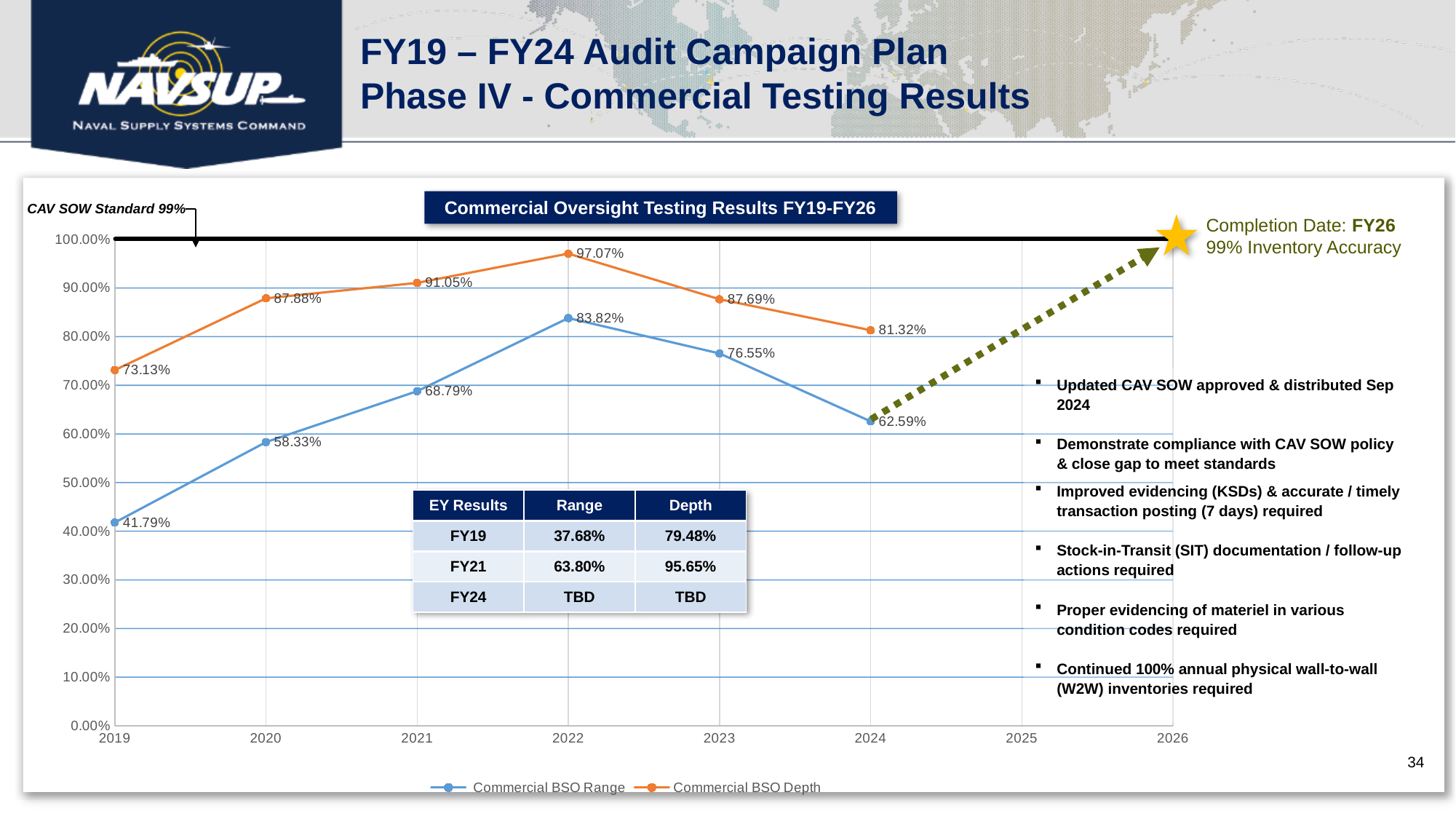
What is the Commercial BSO Range value for 2024? 62.59% In which year is Commercial BSO Range lowest? 2019 Does Commercial BSO Range rise or fall from 2022 to 2024? Fall What is the Commercial BSO Depth value for 2022? 97.07% How many years have data points plotted for Commercial BSO Range? 6 Which is larger in 2023: Commercial BSO Range or Commercial BSO Depth? Commercial BSO Depth In which year is Commercial BSO Depth highest? 2022 What is the title of the chart? Commercial Oversight Testing Results FY19-FY26 What is the difference between Commercial BSO Depth and Commercial BSO Range in 2024? 18.73% What is the Commercial BSO Range value for 2019? 41.79% What type of chart is shown on the slide? Line chart How many series does the chart legend list? 2